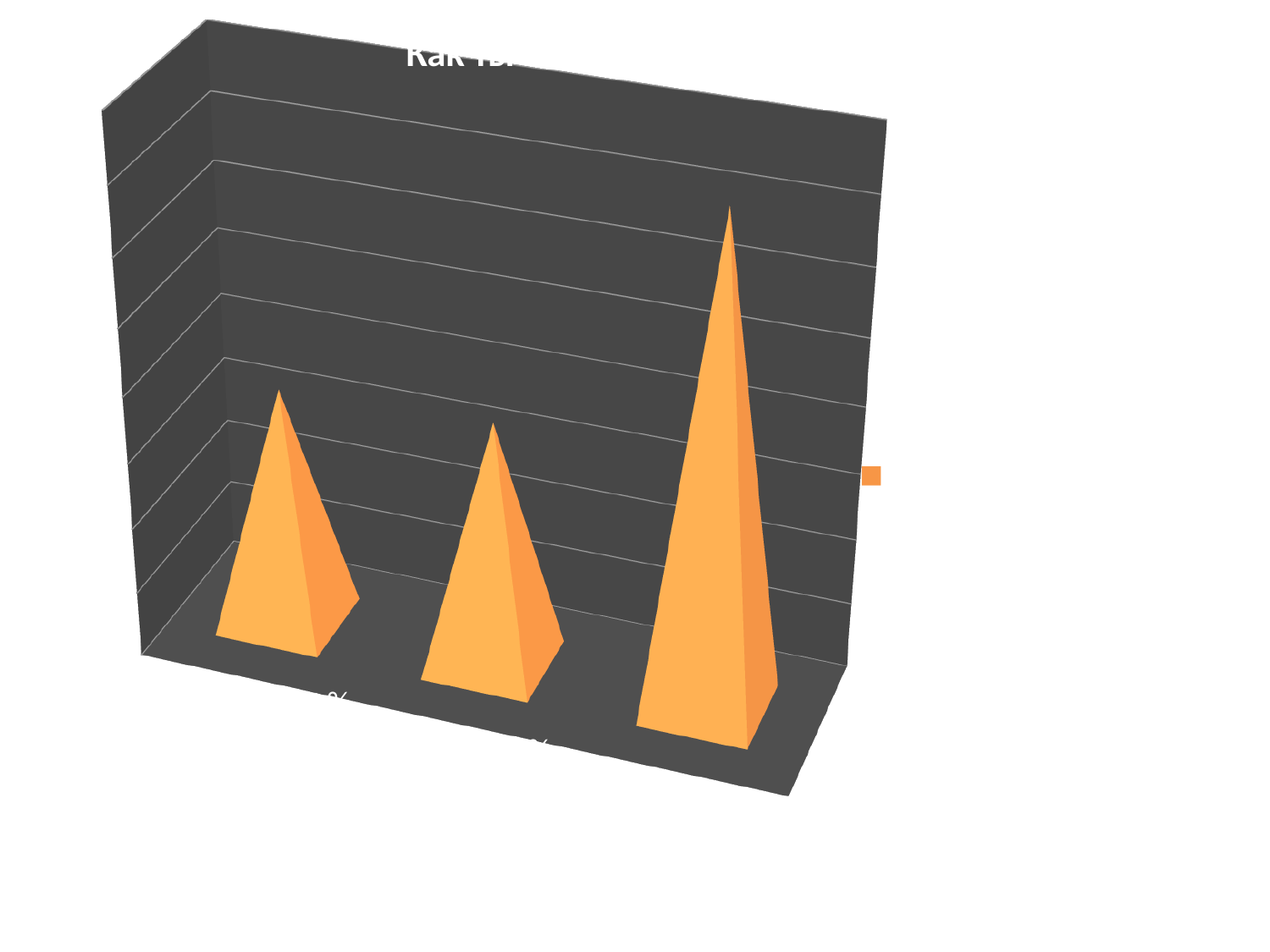
Which bar is the highest: the leftmost, the middle, or the rightmost? the rightmost What shape are the bars drawn as in the chart? pyramids What kind of chart is shown on the slide? bar chart How many bars are plotted in the chart? 3 How many series does the legend list? 1 Which is larger, the rightmost bar or the middle bar? the rightmost bar Which is larger, the leftmost bar or the rightmost bar? the rightmost bar What colour are the bars in the chart? orange